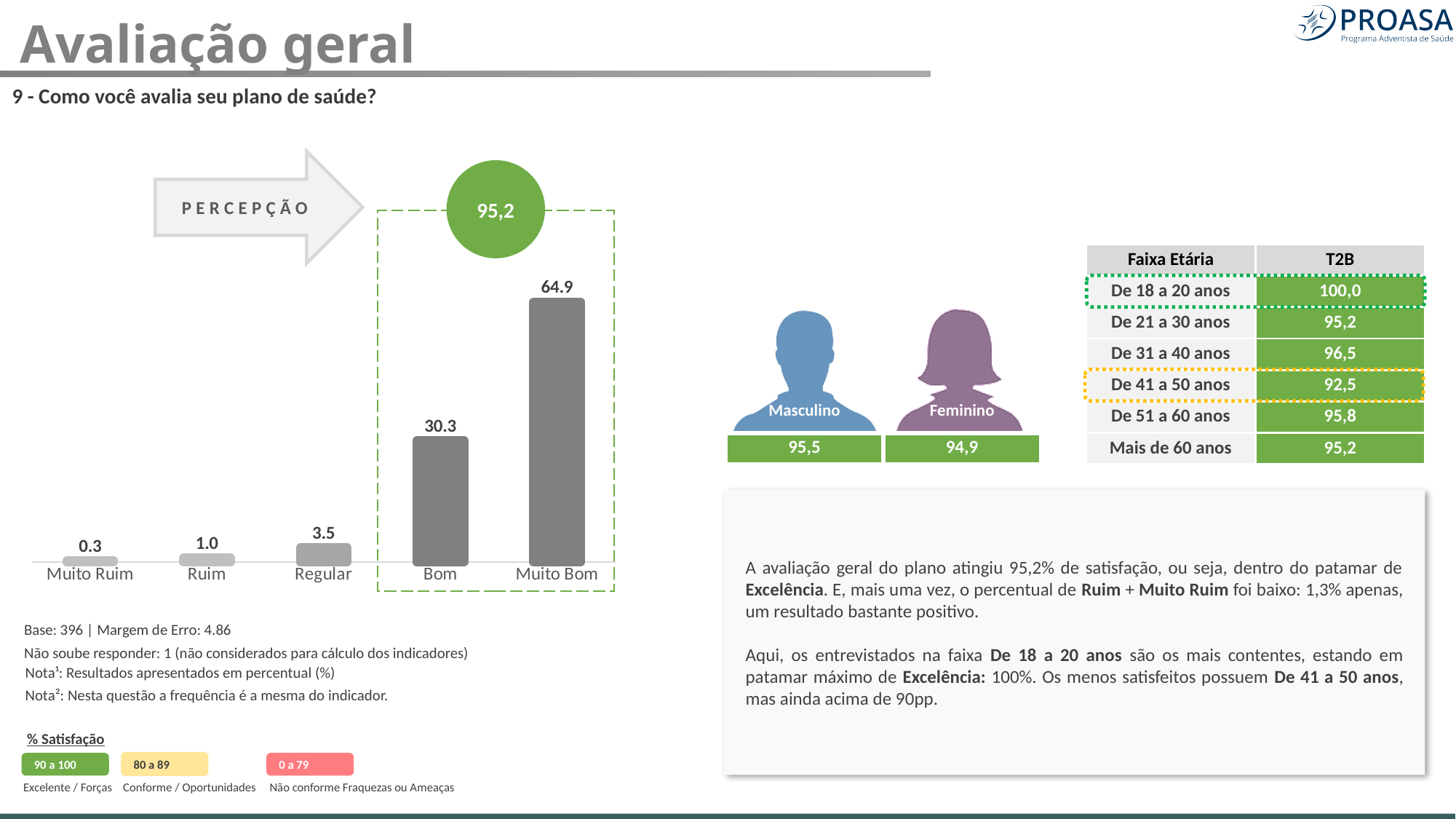
What is the value for Bom in the bar chart? 30.3 How many categories are shown in the bar chart? 5 What is the value for Regular in the bar chart? 3.5 Do the values in the bar chart rise or fall from Muito Ruim to Muito Bom? Rise What kind of chart is shown on the slide? Bar chart Which category has the highest value in the bar chart? Muito Bom What is the difference between the values for Regular and Ruim in the bar chart? 2.5 Which is larger in the bar chart, the value for Ruim or the value for Regular? Regular What is the value for Muito Ruim in the bar chart? 0.3 What is the value for Muito Bom in the bar chart? 64.9 Which category has the lowest value in the bar chart? Muito Ruim What is the difference between the values for Muito Bom and Bom in the bar chart? 34.6